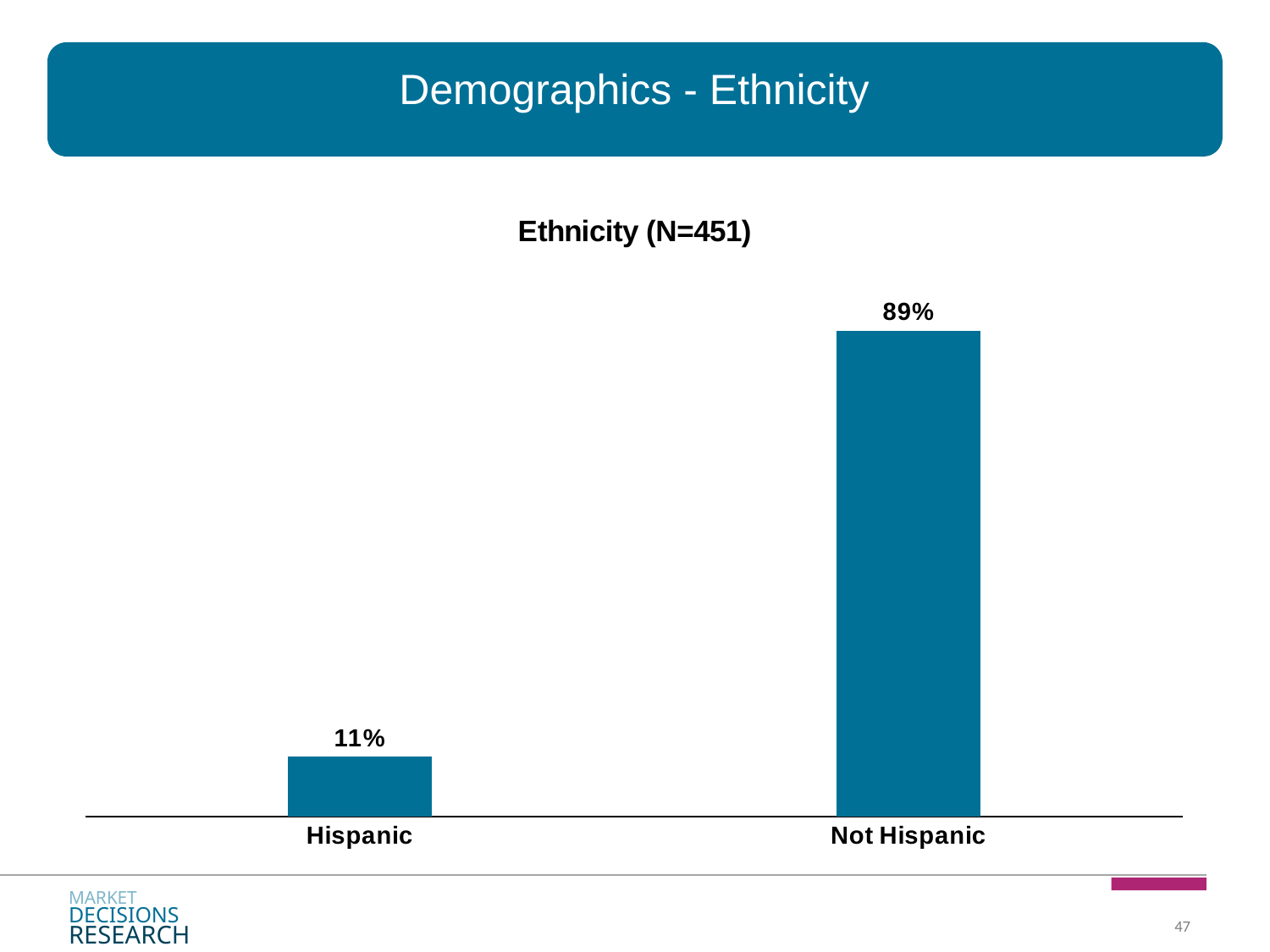
How many categories are shown in the chart? 2 What percentage of respondents are Not Hispanic? 89% What is the total of the two percentages shown in the chart? 100% Which category has the highest value? Not Hispanic Which category has the lowest value? Hispanic What is the title of the chart? Ethnicity (N=451) What is the difference between the Not Hispanic and Hispanic percentages? 78% What is the sample size (N) shown in the chart title? 451 Which is larger, the value for Hispanic or the value for Not Hispanic? Not Hispanic What percentage of respondents are Hispanic? 11% What kind of chart is shown on the slide? Bar chart